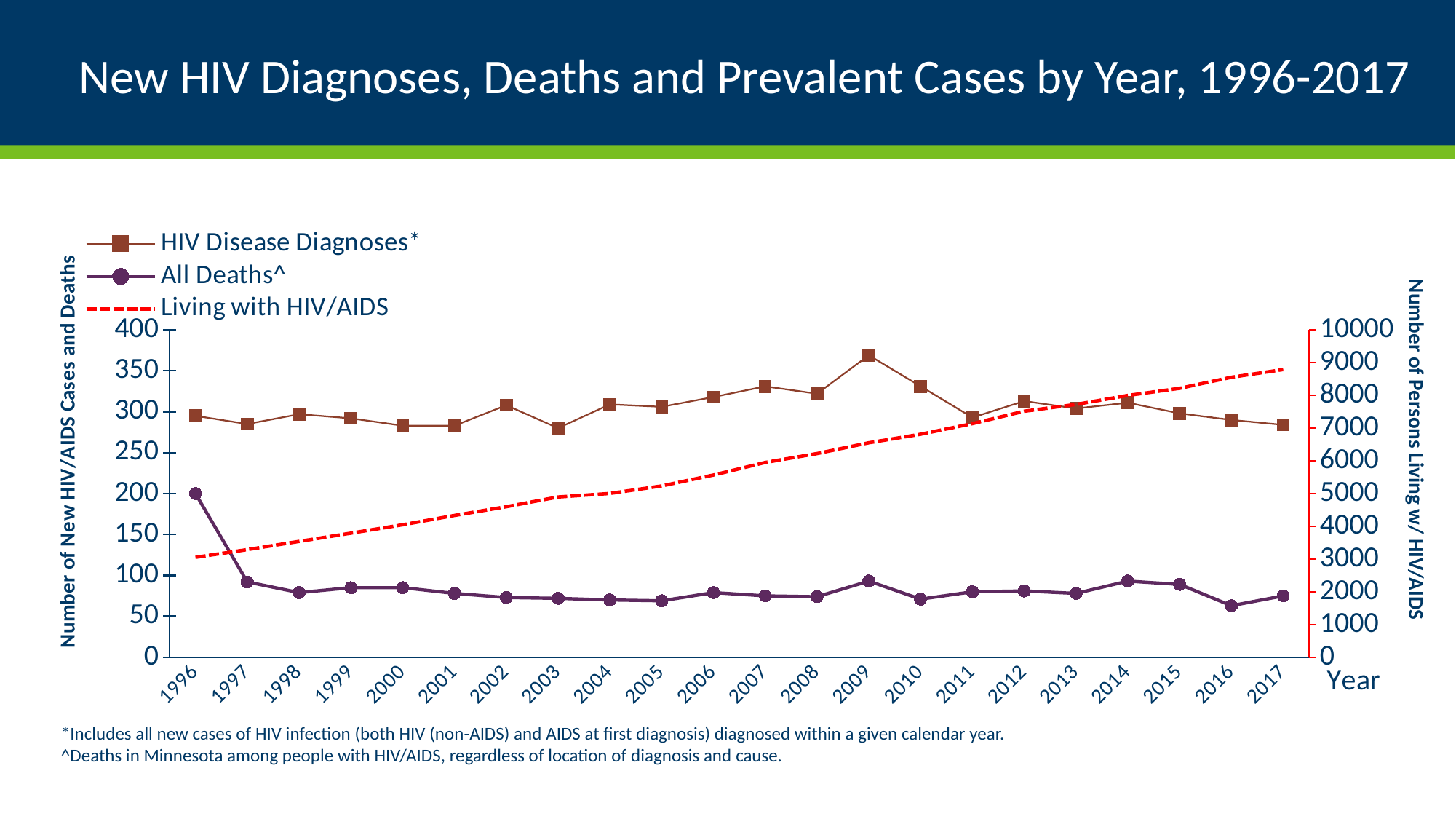
Is the value for HIV Disease Diagnoses in 2009 greater or less than 350? greater In which year is the All Deaths series at its highest? 1996 Does the Living with HIV/AIDS series rise or fall from 1996 to 2017? rise Is the value for All Deaths in 2017 greater or less than 100? less What kind of chart is shown on the slide? line chart Is the value for All Deaths in 1996 greater or less than 150? greater How many years are plotted along the x axis? 22 In which year is the HIV Disease Diagnoses series at its highest? 2009 Which series is drawn as a red dashed line? Living with HIV/AIDS How many series does the legend list? 3 Which year has the larger value for HIV Disease Diagnoses, 2009 or 2010? 2009